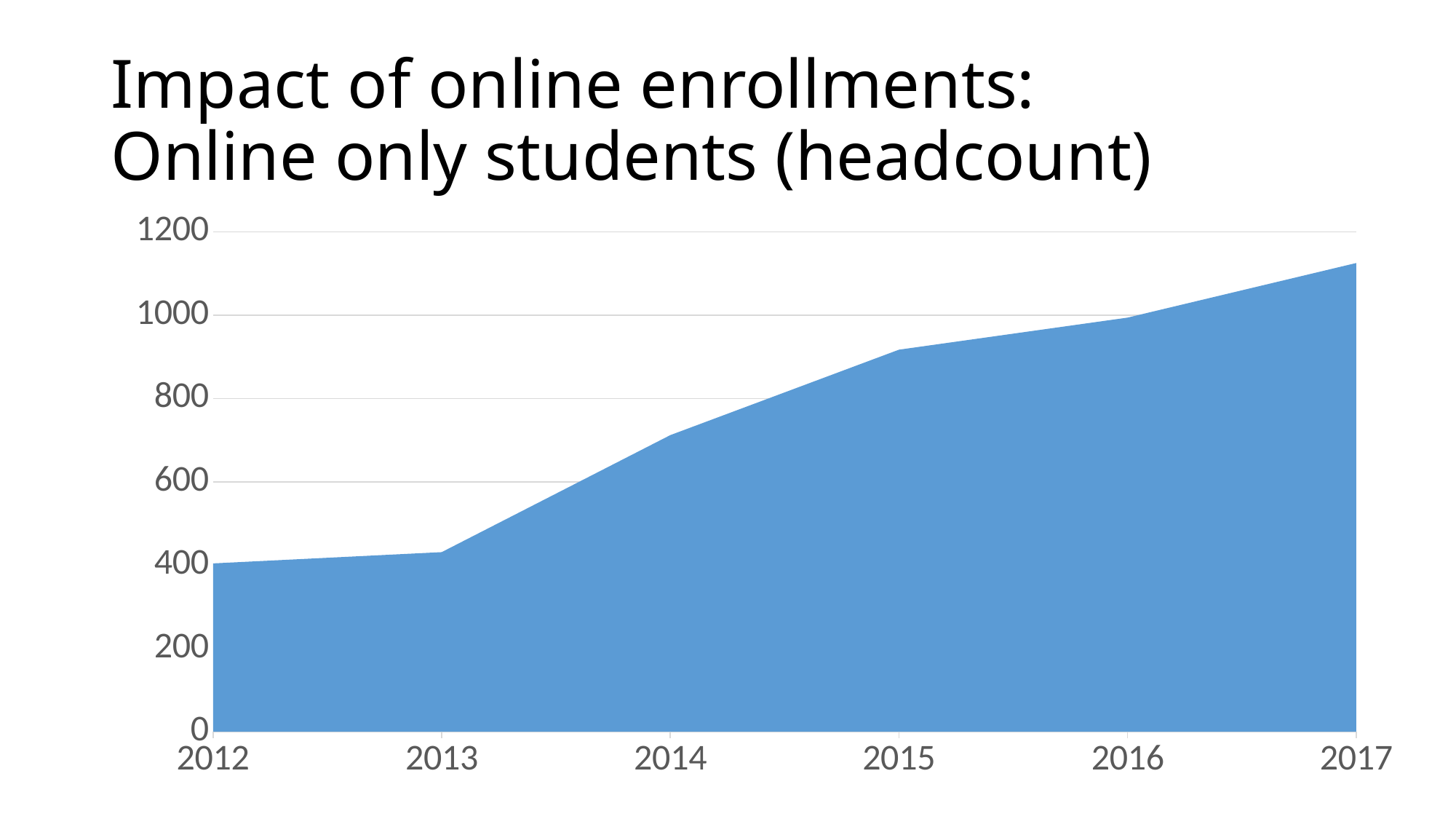
What is the title of the slide? Impact of online enrollments: Online only students (headcount) Is the value for 2017 greater or less than 1000? greater What kind of chart is shown on the slide? Area chart Is the value for 2014 greater or less than 600? greater What is the highest value shown on the y axis? 1200 Is the value for 2015 greater or less than 800? greater How many years are plotted along the x axis? 6 Do the values rise or fall from 2012 to 2017? Rise Which year has the highest headcount of online only students? 2017 Which is larger, the value for 2015 or the value for 2014? 2015